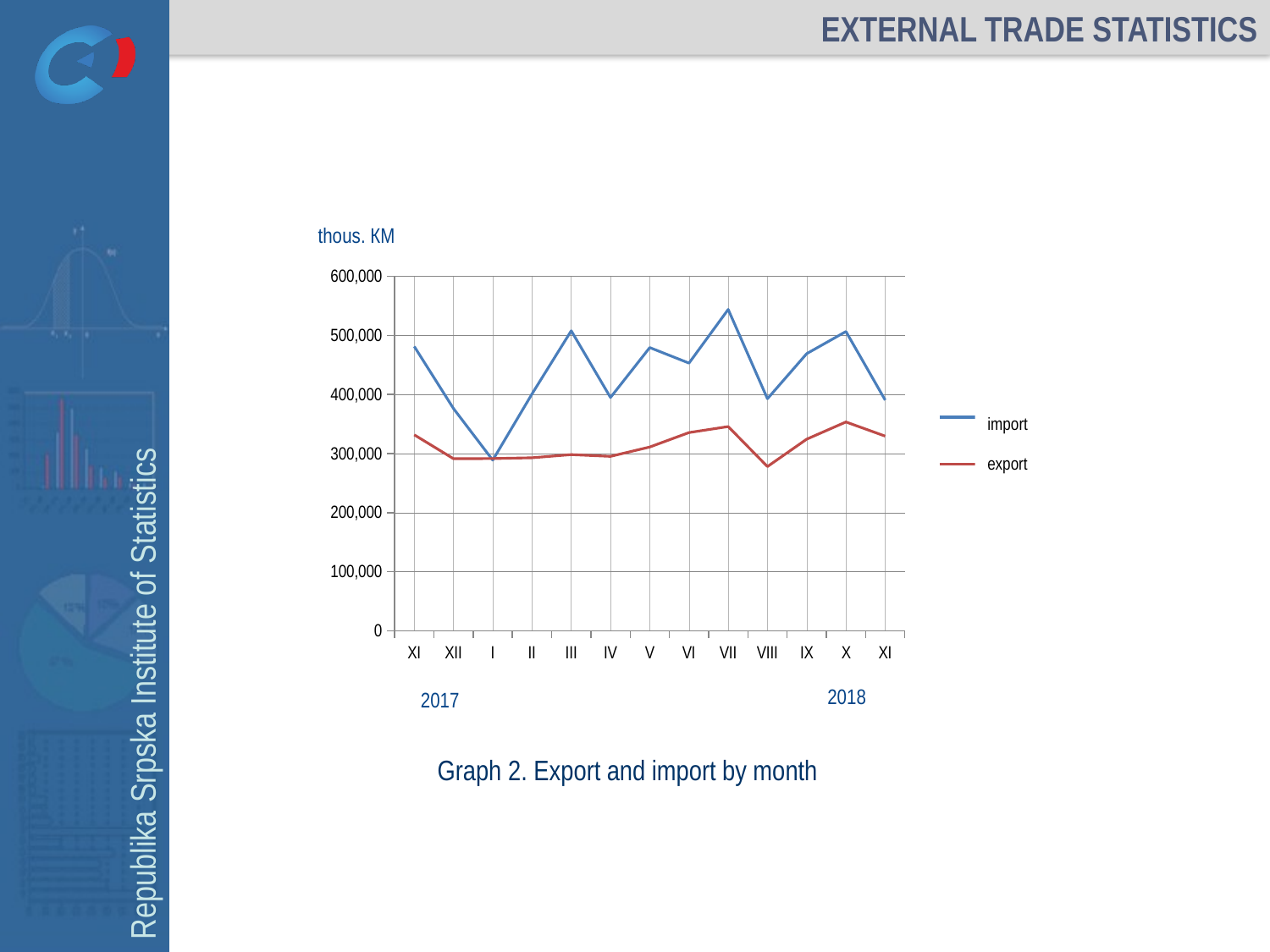
In which month does the import series reach its highest value? VII (2018) In which month does the export series reach its highest value? X (2018) Is the export value for VIII 2018 greater or less than 300,000? less In which month does the export series reach its lowest value? VIII (2018) Is the import value for XI 2017 greater or less than 400,000? greater Is the import value for VII 2018 greater or less than 500,000? greater Which is larger in VII 2018, import or export? import How many series does the legend of Graph 2 list? 2 What kind of chart is Graph 2? line chart What unit is shown above the y axis of Graph 2? thous. KM How many monthly points are plotted along the x axis of Graph 2? 13 In which month does the import series reach its lowest value? I (2018)